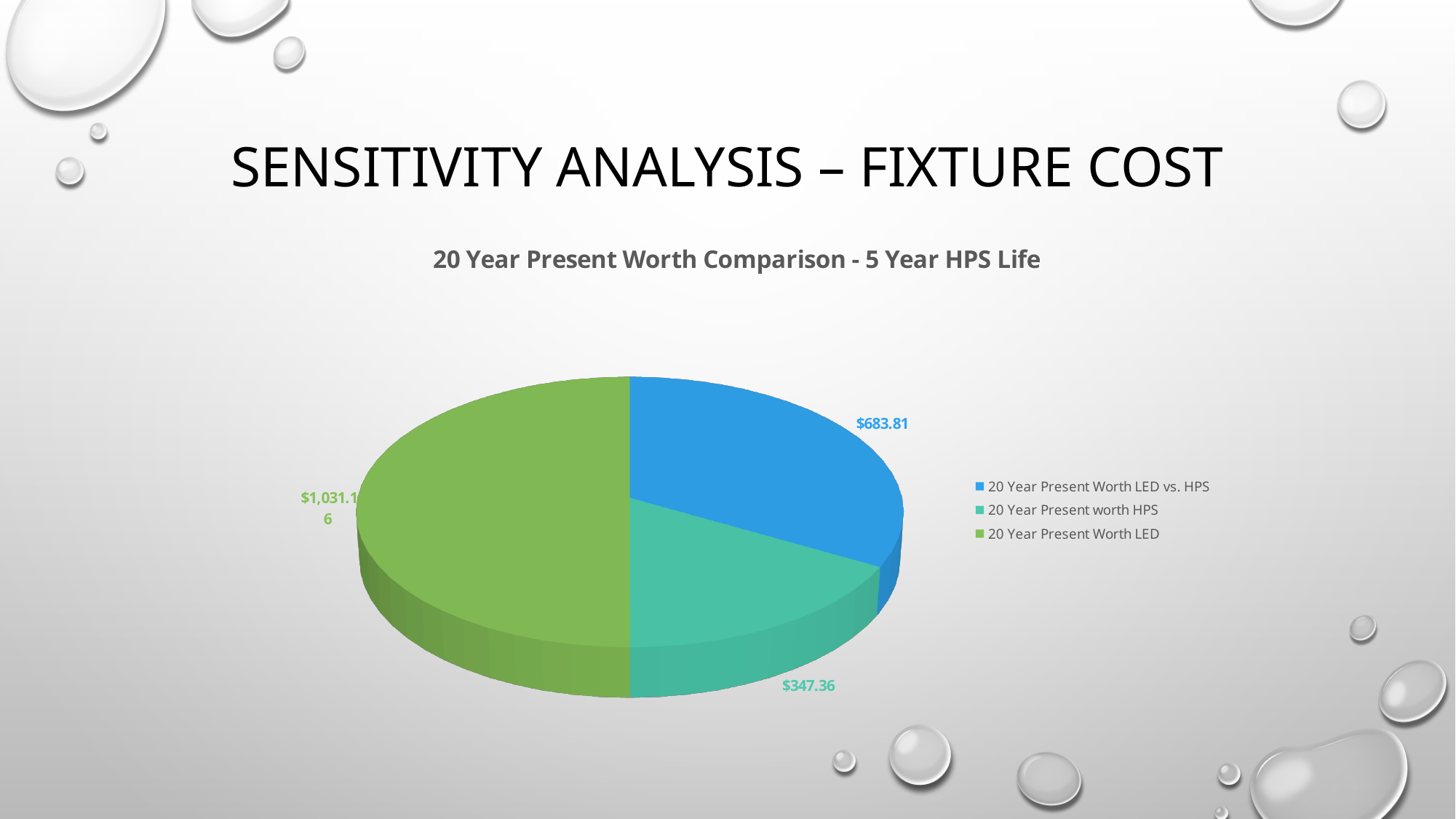
What is the difference between the 20 Year Present Worth LED vs. HPS value and the 20 Year Present worth HPS value? $336.45 What kind of chart is shown on the slide? Pie chart What is the difference between the 20 Year Present Worth LED value and the 20 Year Present worth HPS value? $683.80 What is the value shown for the 20 Year Present worth HPS slice? $347.36 How many slices does the pie chart have? 3 To the nearest whole percent, what share of the pie does the 20 Year Present Worth LED slice represent? 50% Which is larger: the 20 Year Present Worth LED vs. HPS value or the 20 Year Present worth HPS value? 20 Year Present Worth LED vs. HPS What is the title of the chart? 20 Year Present Worth Comparison - 5 Year HPS Life Which slice of the pie has the largest value? 20 Year Present Worth LED Which slice of the pie has the smallest value? 20 Year Present worth HPS What is the value shown for the 20 Year Present Worth LED vs. HPS slice? $683.81 What is the value shown for the 20 Year Present Worth LED slice? $1,031.16